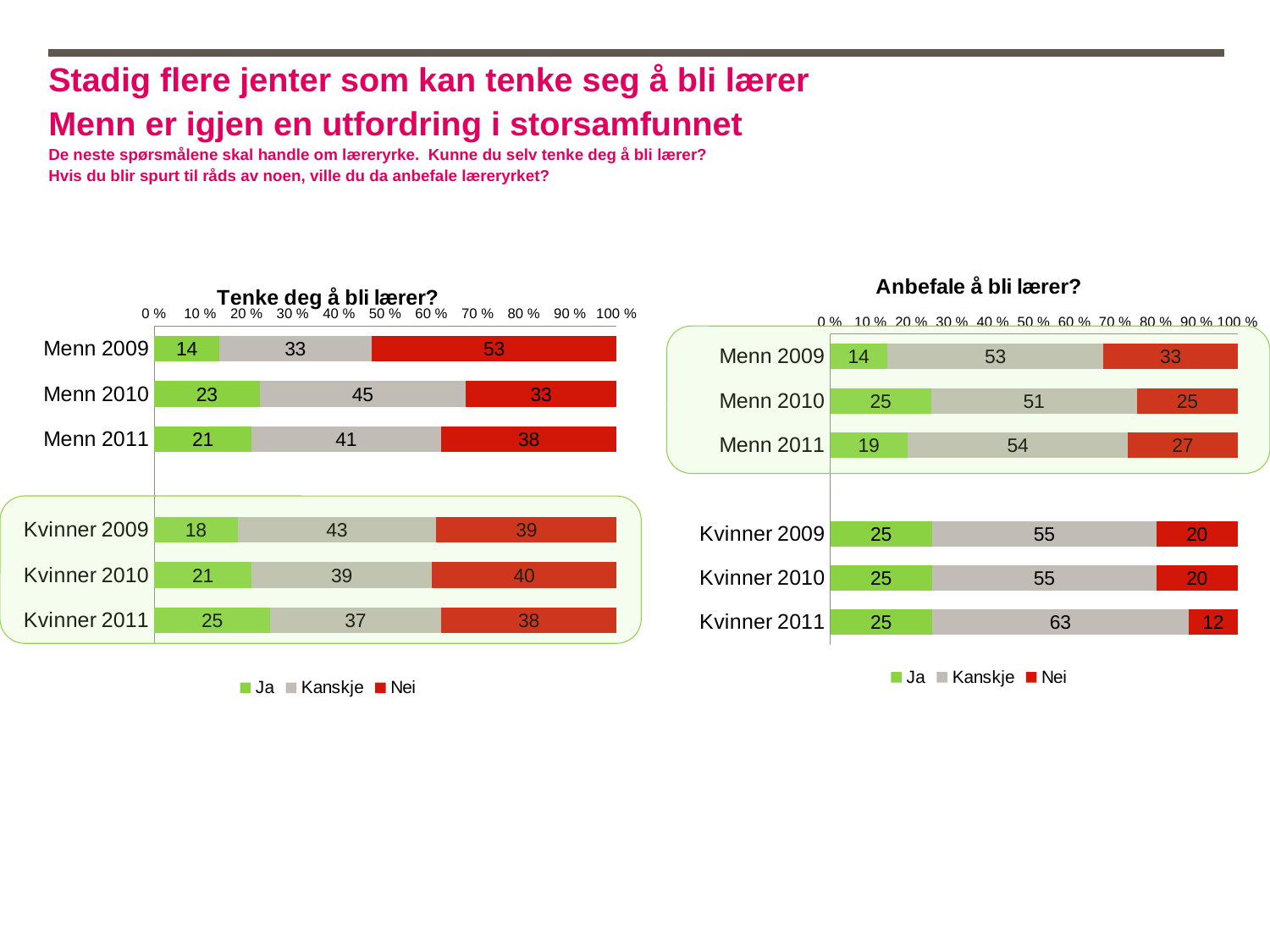
In the 'Tenke deg å bli lærer?' chart, what is the total of the stacked bar for Kvinner 2011? 100 In the 'Anbefale å bli lærer?' chart, what is the 'Ja' value for Menn 2011? 19 In the 'Tenke deg å bli lærer?' chart, which category has the highest 'Ja' value? Kvinner 2011 In the 'Tenke deg å bli lærer?' chart, what is the difference between the 'Nei' values for Menn 2009 and Menn 2010? 20 How many categories are shown in the 'Tenke deg å bli lærer?' chart? 6 In the 'Anbefale å bli lærer?' chart, what is the 'Kanskje' value for Kvinner 2011? 63 What are the legend entries of the 'Tenke deg å bli lærer?' chart? Ja, Kanskje, Nei In the 'Anbefale å bli lærer?' chart, which category has the lowest 'Nei' value? Kvinner 2011 How many series does the legend of the 'Anbefale å bli lærer?' chart list? 3 In the 'Tenke deg å bli lærer?' chart, what is the 'Nei' value for Menn 2009? 53 In the 'Anbefale å bli lærer?' chart, which is larger: the 'Ja' value for Menn 2010 or for Menn 2011? Menn 2010 What kind of chart is the 'Tenke deg å bli lærer?' chart? Stacked bar chart